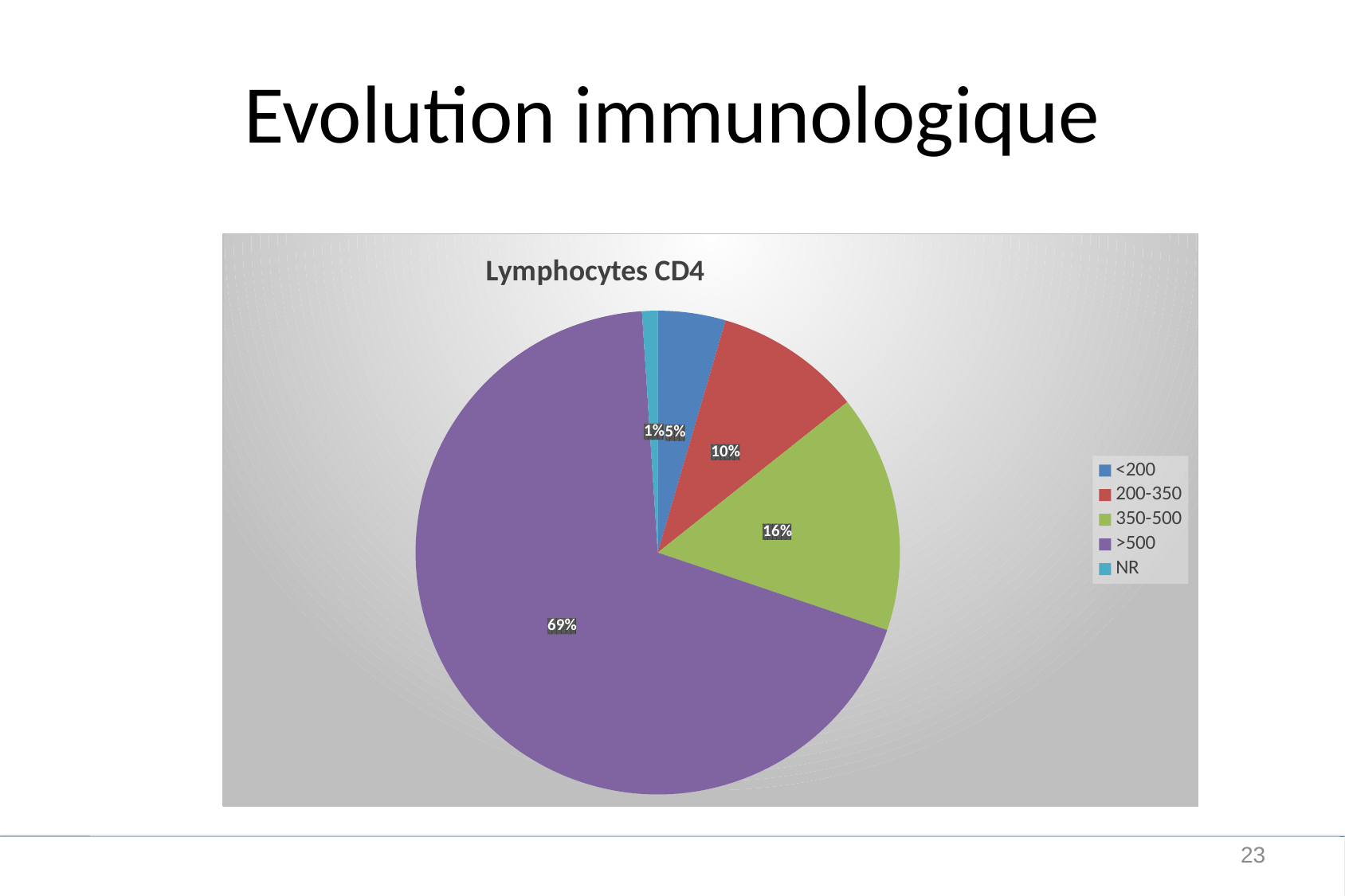
Which category has the largest slice of the pie? >500 Which category has the smallest slice of the pie? NR How many categories does the legend list? 5 What is the difference between the shares of the >500 and 350-500 categories? 53% What share of the pie does the 350-500 category have? 16% Which is larger, the share for 200-350 or the share for <200? 200-350 What share of the pie does the 200-350 category have? 10% What is the title of the chart? Lymphocytes CD4 What share of the pie does the NR category have? 1% What kind of chart is shown on the slide? pie chart